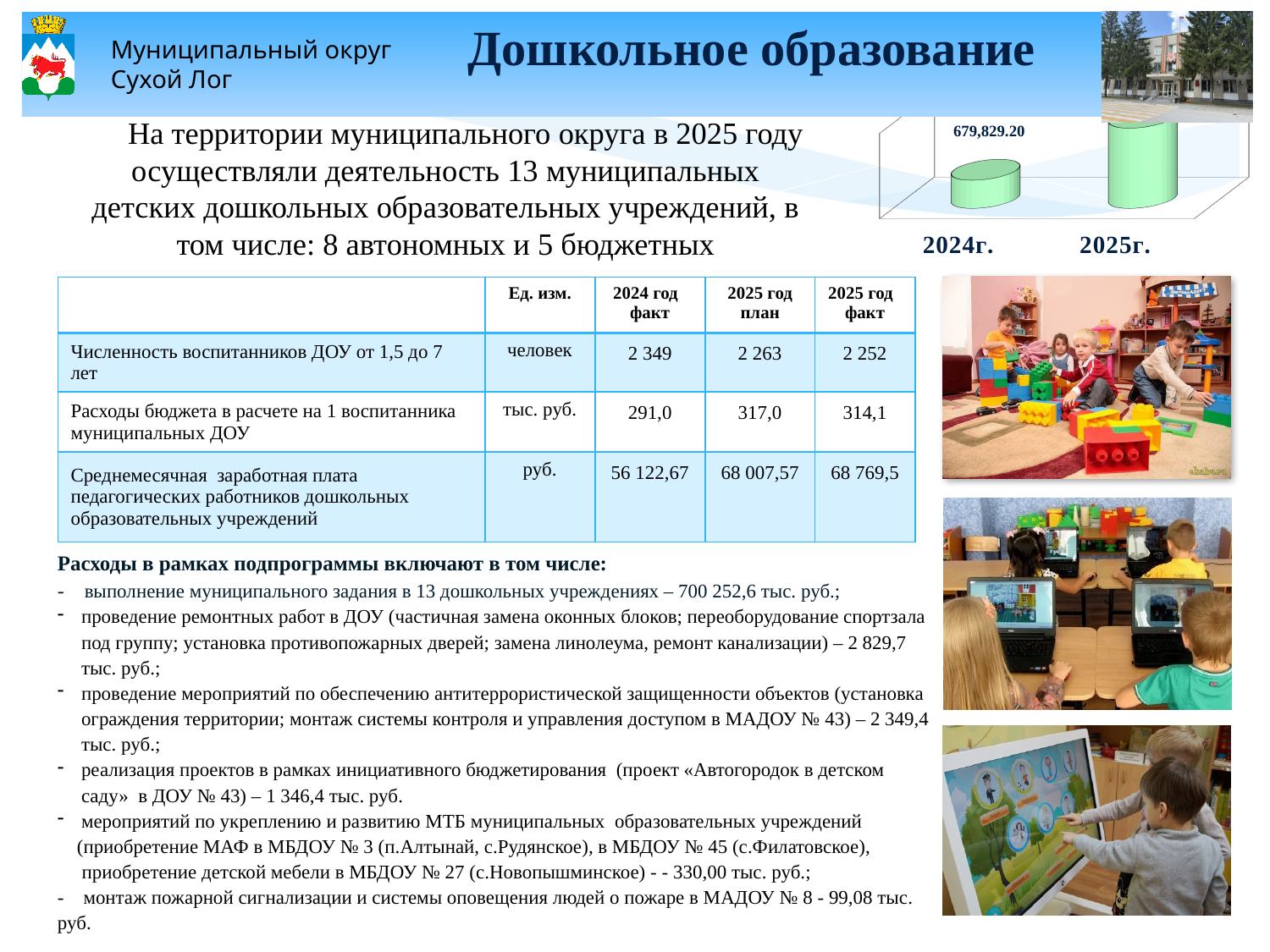
In the chart at the top right of the slide, which year has the taller bar? 2025г. In the chart at the top right of the slide, do the values rise or fall from 2024г. to 2025г.? rise How many categories does the chart at the top right of the slide show? 2 In the chart at the top right of the slide, which year has the shorter bar? 2024г. In the chart at the top right of the slide, is the bar for 2025г. larger or smaller than the bar for 2024г.? larger What kind of chart is shown at the top right of the slide? bar chart What are the category labels shown under the bars in the chart at the top right of the slide? 2024г. and 2025г.